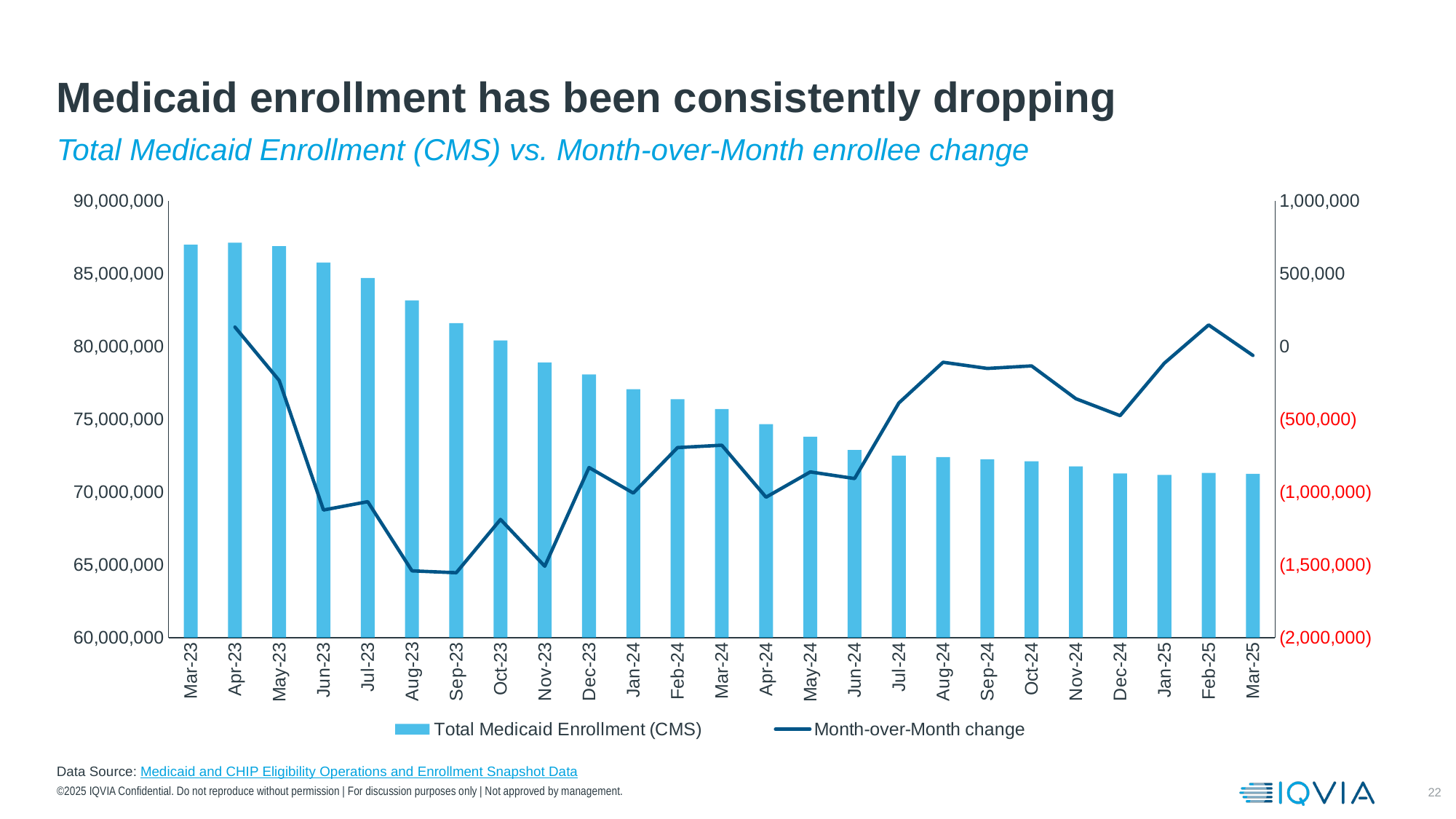
Which month has the higher Month-over-Month change, Nov-23 or Dec-23? Dec-23 Which has the larger Total Medicaid Enrollment (CMS), Mar-23 or Mar-25? Mar-23 Is the Month-over-Month change for Sep-23 greater or less than (1,000,000)? less Is the Total Medicaid Enrollment (CMS) bar for Jul-24 greater or less than 75,000,000? less Is the Month-over-Month change for Apr-23 greater or less than 0? greater How many months are plotted along the x axis? 25 Does Total Medicaid Enrollment (CMS) generally rise or fall from Mar-23 to Mar-25? Fall What is the subtitle of the chart? Total Medicaid Enrollment (CMS) vs. Month-over-Month enrollee change How many series does the legend list? 2 What kind of chart is shown on the slide? A combined bar and line chart